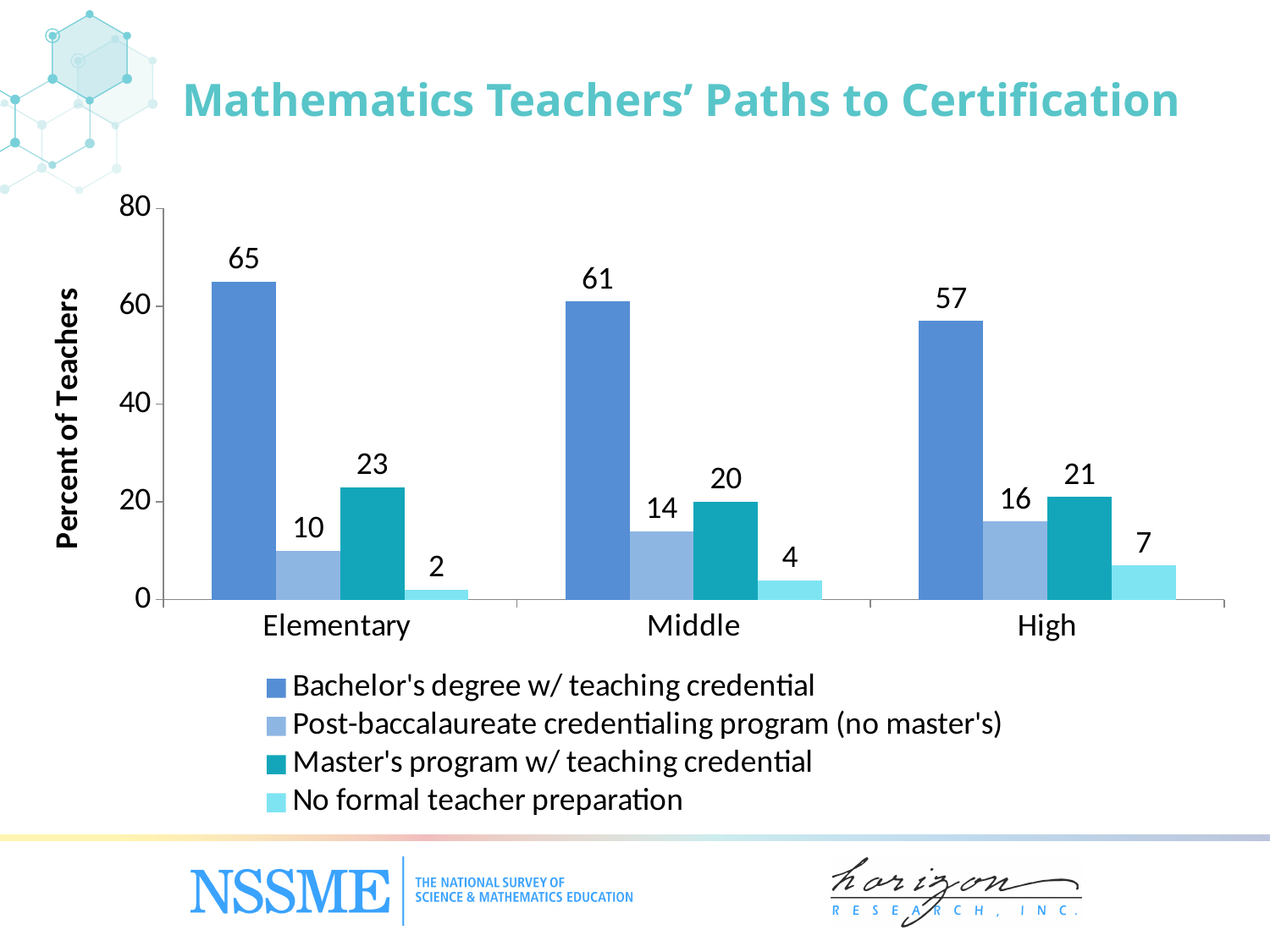
What kind of chart is shown on the slide? Bar chart How many school levels are shown on the x axis? 3 Is the 'Post-baccalaureate credentialing program (no master's)' value larger for Elementary or High? High Do the 'Bachelor's degree w/ teaching credential' values rise or fall from Elementary to High? Fall Which school level has the lowest value for 'Bachelor's degree w/ teaching credential'? High What is the value for 'Post-baccalaureate credentialing program (no master's)' for Middle school teachers? 14 What is the label of the y axis? Percent of Teachers What percent of elementary mathematics teachers earned a bachelor's degree with teaching credential? 65 Which school level has the highest value for 'Master's program w/ teaching credential'? Elementary How many series does the legend list? 4 What is the difference between the 'Bachelor's degree w/ teaching credential' values for Elementary and High? 8 What is the value for 'No formal teacher preparation' at the High school level? 7